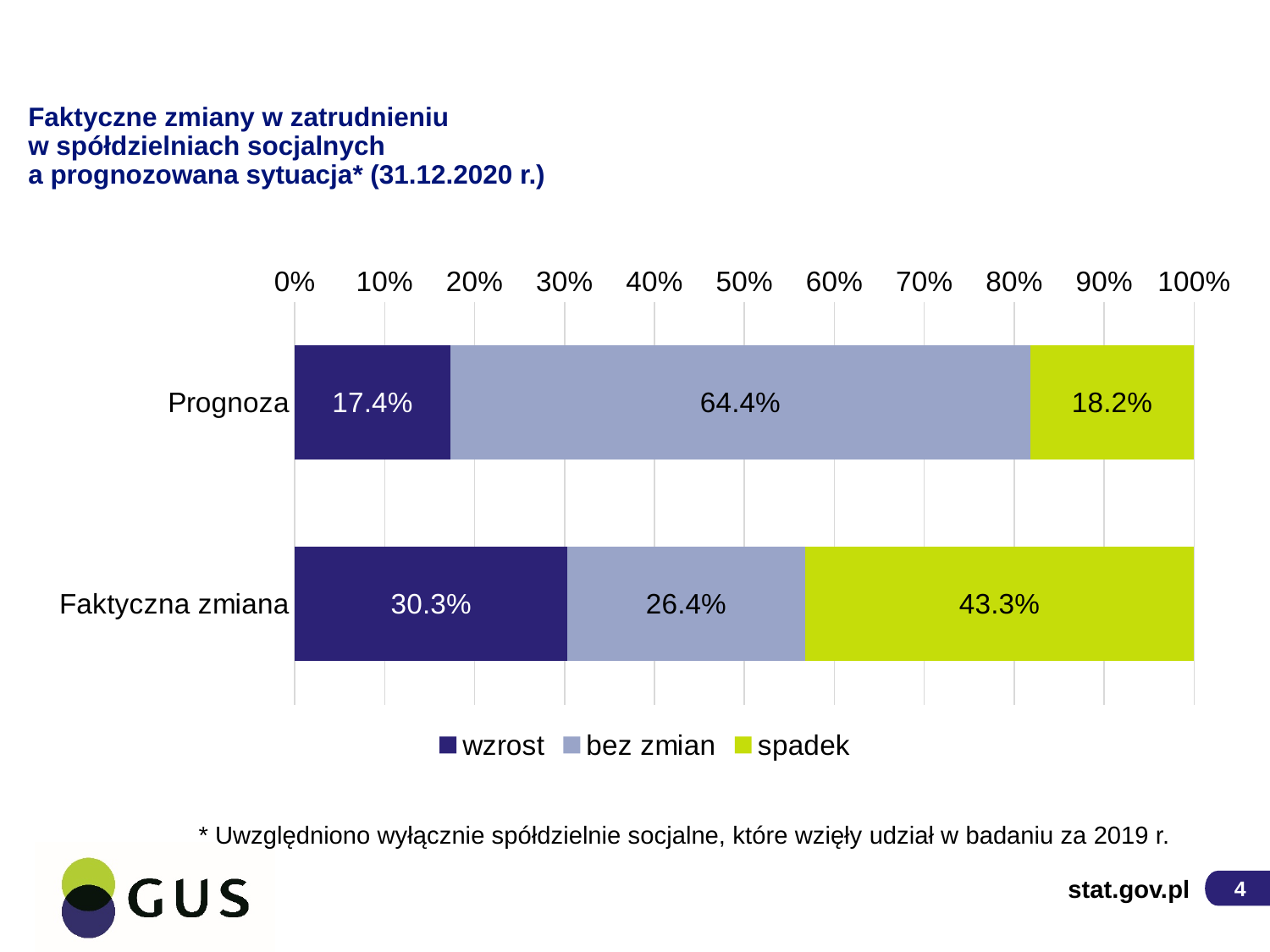
Which is larger: the "wzrost" value for "Prognoza" or for "Faktyczna zmiana"? Faktyczna zmiana Which legend entry is shown in yellow-green? spadek How many categories (bars) are shown in the chart? 2 Which series has the smallest share in the "Faktyczna zmiana" bar? bez zmian What is the value for "wzrost" in the "Faktyczna zmiana" bar? 30.3% What is the value for "bez zmian" in the "Faktyczna zmiana" bar? 26.4% What is the difference between the "spadek" values for "Faktyczna zmiana" and "Prognoza"? 25.1% How many series does the legend list? 3 Which series has the largest share in the "Prognoza" bar? bez zmian What kind of chart is shown on the slide? Stacked bar chart What is the value for "wzrost" in the "Prognoza" bar? 17.4% What is the value for "spadek" in the "Prognoza" bar? 18.2%